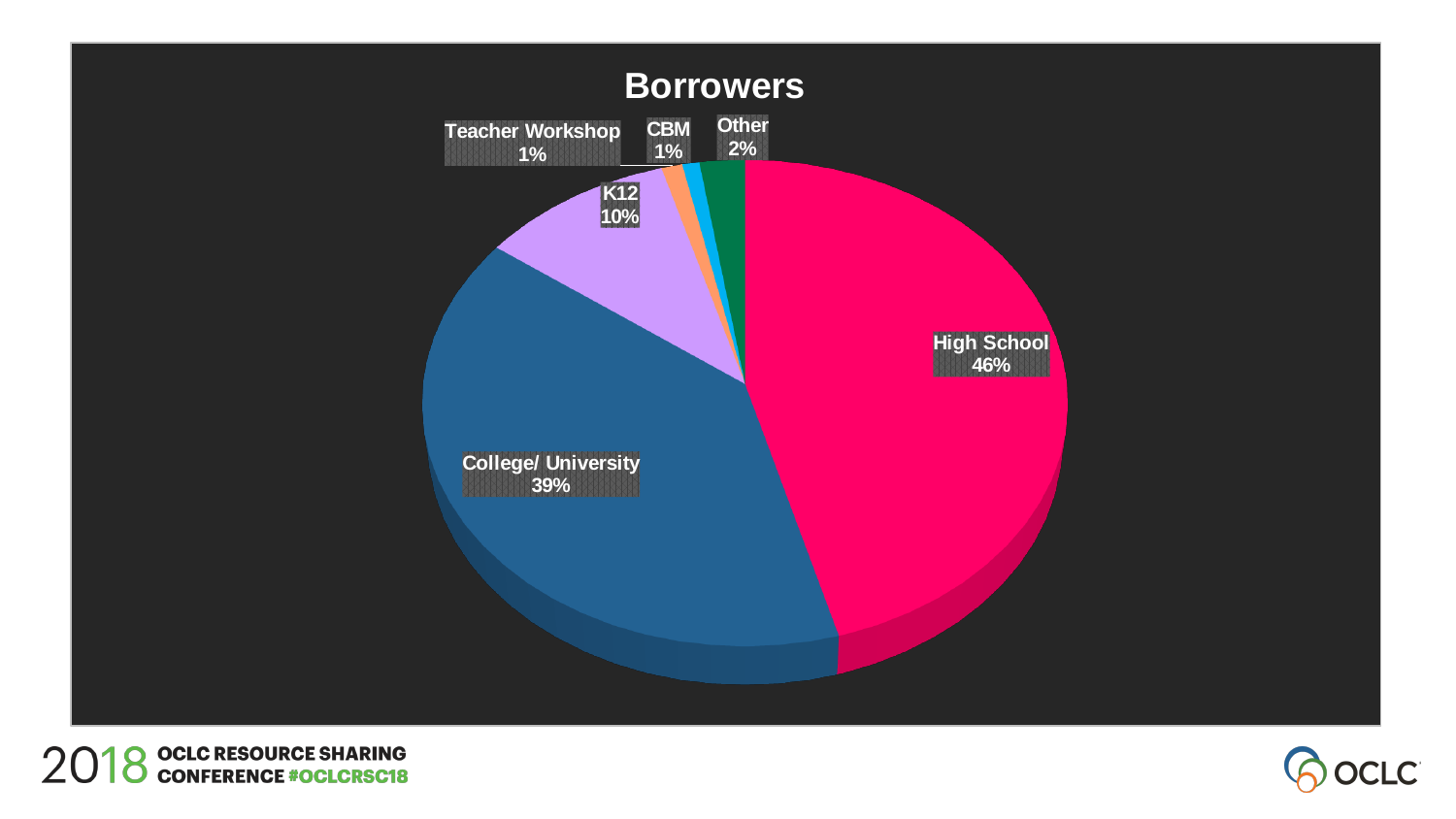
Which category has the largest share of borrowers? High School What share of borrowers is College/ University? 39% What share of borrowers is Teacher Workshop? 1% What kind of chart is shown on the slide? pie chart Which is larger, the share for K12 or the share for Other? K12 What is the difference in percentage points between High School and College/ University? 7 What share of borrowers is Other? 2% What is the title of the chart? Borrowers How many categories are shown in the pie chart? 6 What is the combined share of High School and College/ University? 85% What share of borrowers is K12? 10% What share of borrowers is High School? 46%